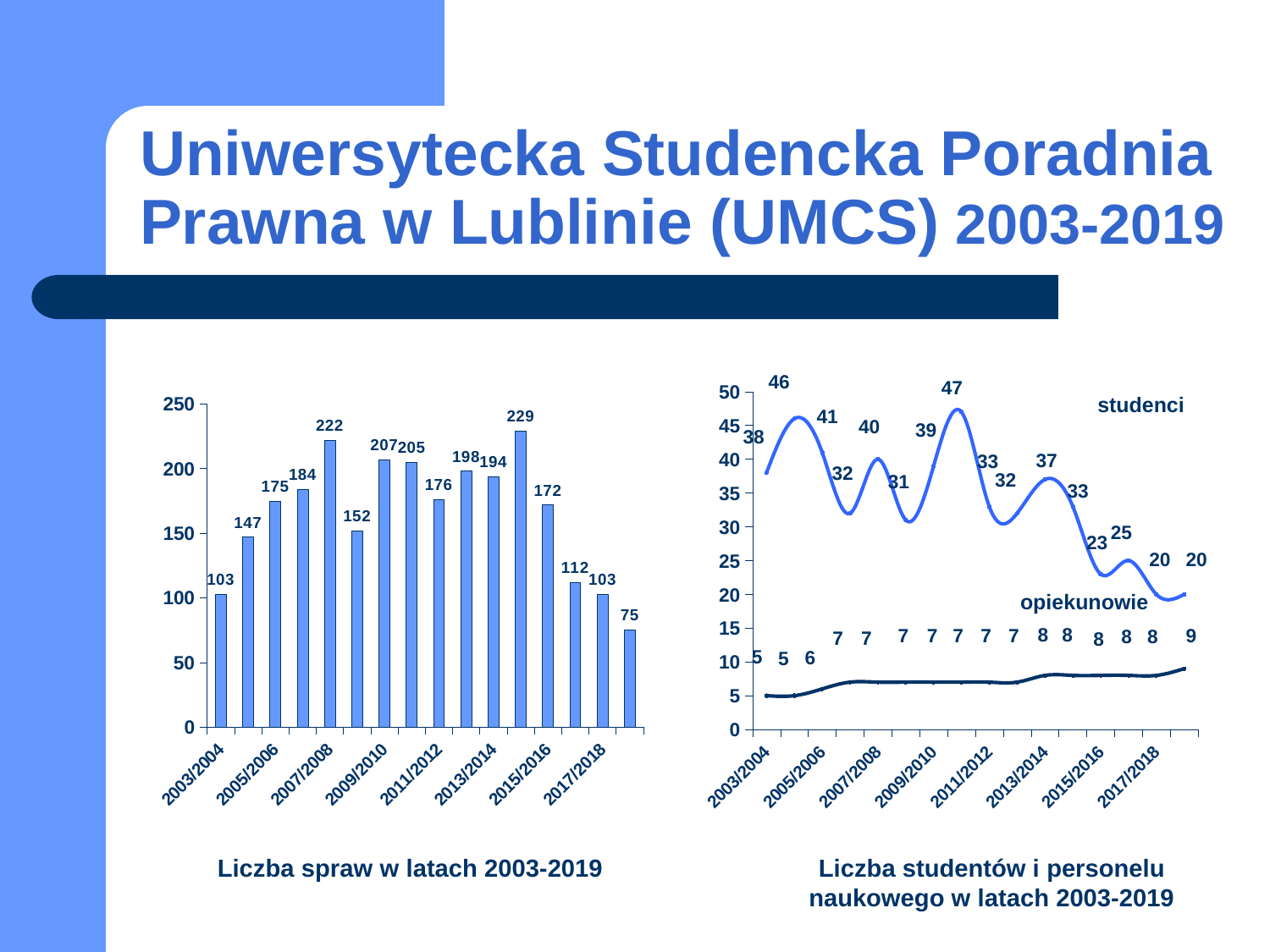
In the chart 'Liczba studentów i personelu naukowego w latach 2003-2019', what is the value of the 'studenci' series for 2003/2004? 38 In the chart 'Liczba studentów i personelu naukowego w latach 2003-2019', what is the highest value of the 'studenci' series? 47 In the chart 'Liczba spraw w latach 2003-2019', what is the lowest value shown on any bar? 75 In the chart 'Liczba spraw w latach 2003-2019', which is larger, the value for 2005/2006 or the value for 2015/2016? 2005/2006 In the chart 'Liczba spraw w latach 2003-2019', what is the highest value shown on any bar? 229 In the chart 'Liczba spraw w latach 2003-2019', what is the value for 2003/2004? 103 How many bars are in the chart 'Liczba spraw w latach 2003-2019'? 16 In the chart 'Liczba spraw w latach 2003-2019', what is the value for 2007/2008? 222 In the chart 'Liczba studentów i personelu naukowego w latach 2003-2019', what is the value of the 'opiekunowie' series for 2017/2018? 8 How many series are shown in the chart 'Liczba studentów i personelu naukowego w latach 2003-2019'? 2 What kind of chart is 'Liczba spraw w latach 2003-2019'? bar chart In the chart 'Liczba spraw w latach 2003-2019', what is the difference between the values for 2009/2010 and 2011/2012? 31